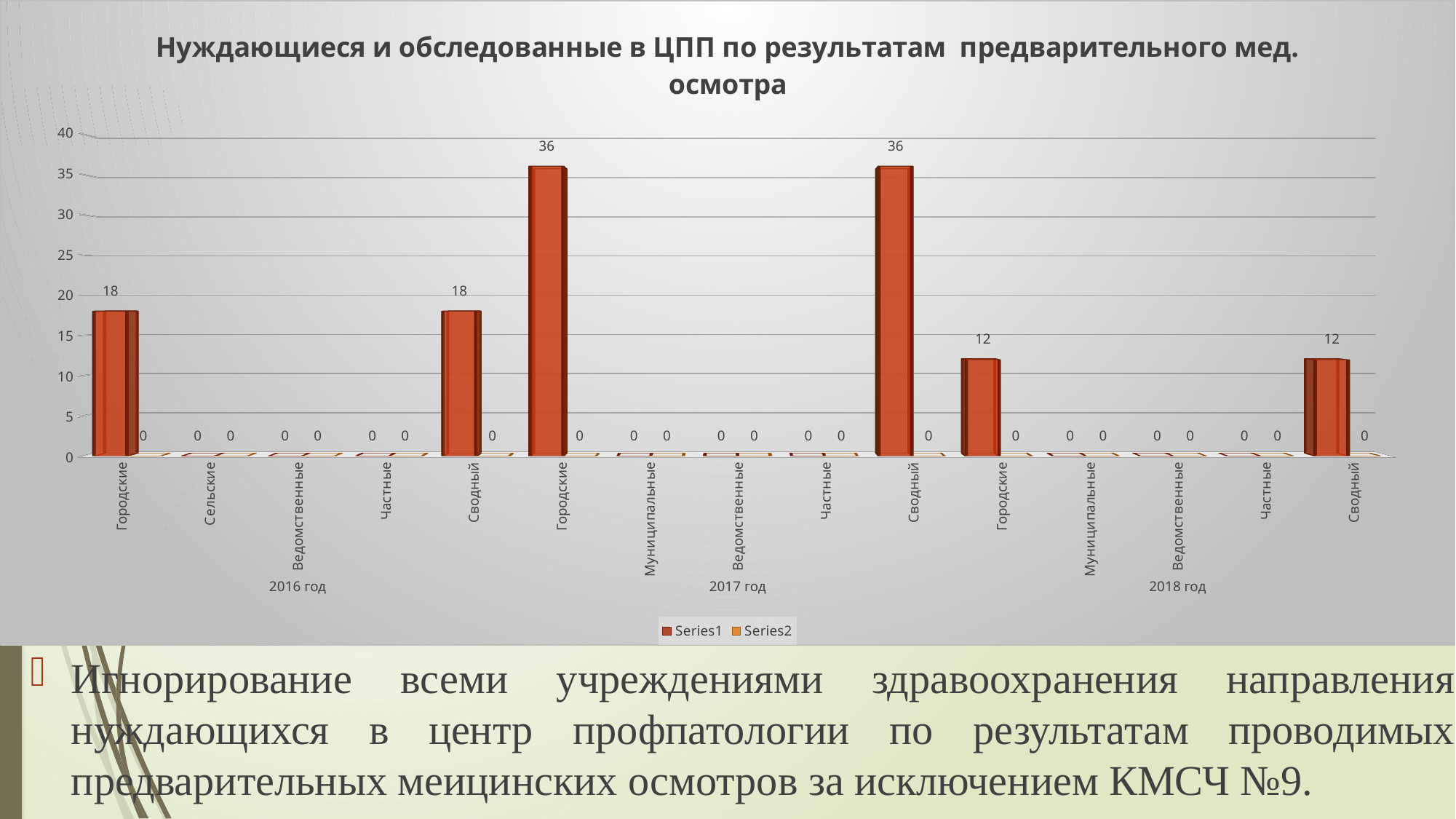
What is the Series2 value for Сводный in 2017 год? 0 How many series does the legend list? 2 Which year has the highest Series1 value for Городские? 2017 год How many categories are shown along the x axis in total? 15 What is the Series1 value for Ведомственные in 2018 год? 0 What is the Series1 value for Сводный in 2018 год? 12 What is the difference between the Series1 value for Городские in 2017 год and in 2018 год? 24 Which year has the lowest Series1 value for Сводный? 2018 год Which is larger: the Series1 value for Сводный in 2016 год or in 2018 год? 2016 год What is the Series1 value for Городские in 2016 год? 18 What kind of chart is shown on the slide? Bar chart What is the Series1 value for Городские in 2017 год? 36